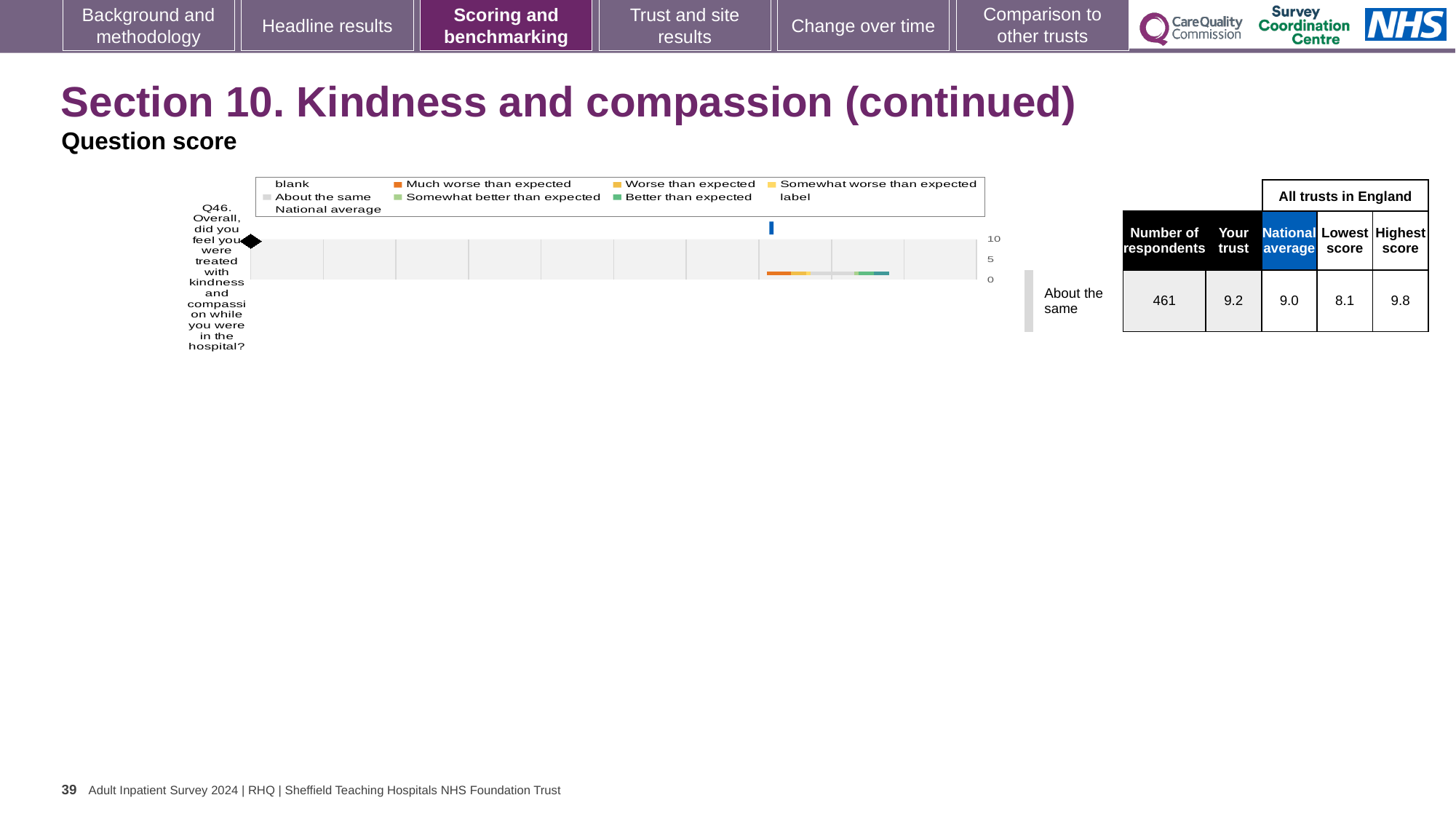
What is the highest score among all trusts in England for Q46? 9.8 What is the lowest score among all trusts in England for Q46? 8.1 What benchmark category is the trust's Q46 result labelled as? About the same Which is larger for Q46, the 'Your trust' score or the national average? Your trust What is the 'Your trust' score for Q46 shown in the table next to the chart? 9.2 By how much does the 'Your trust' score exceed the national average for Q46? 0.2 What kind of chart is shown on the slide for Q46? bar chart What is the difference between the highest score and the lowest score for Q46? 1.7 What is the highest value shown on the chart's score axis? 10 What is the national average score for Q46 shown in the table? 9.0 How many survey questions are plotted on the chart? 1 How many respondents answered Q46? 461